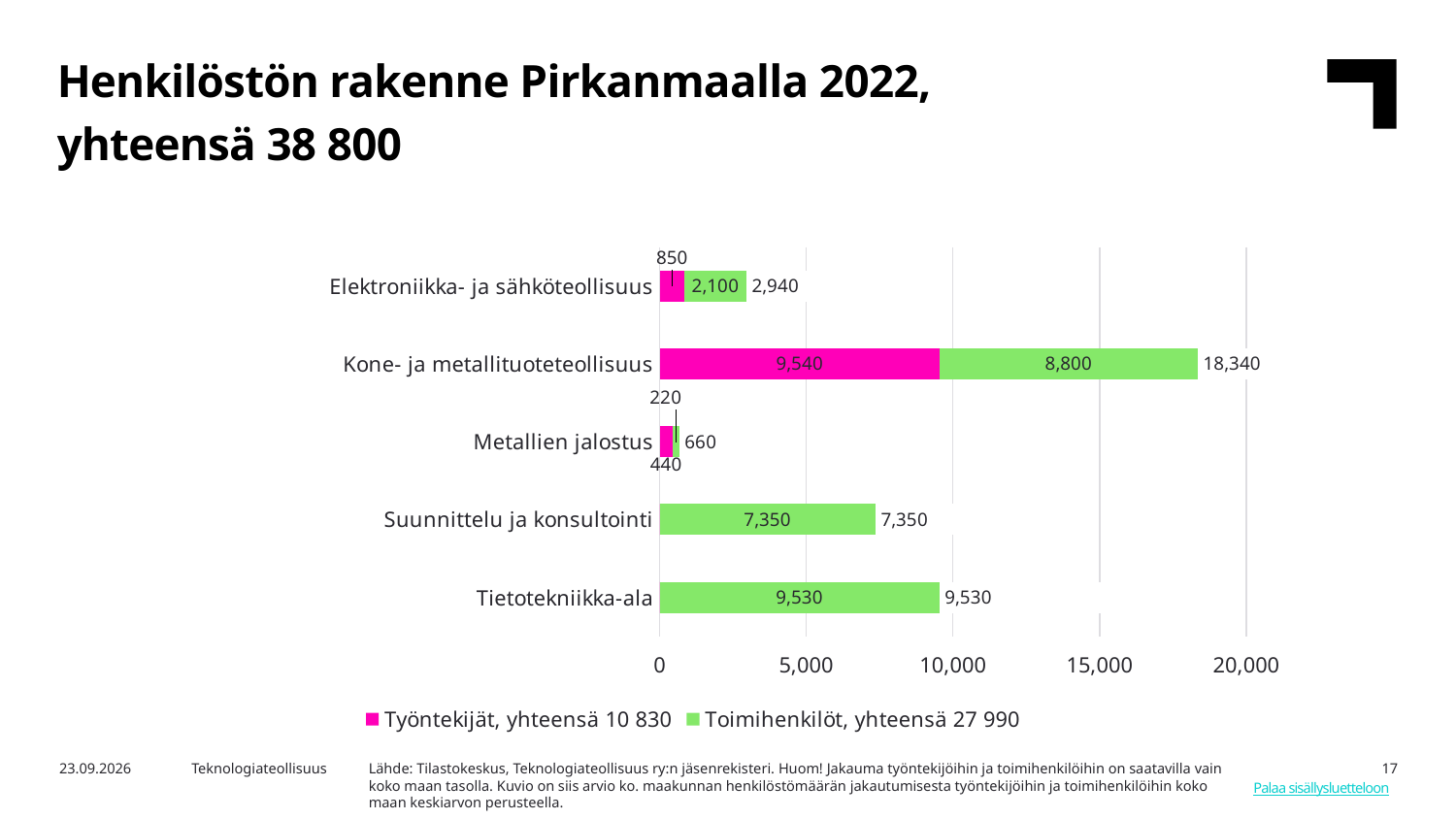
What is the difference between the Työntekijät and Toimihenkilöt values for Kone- ja metallituoteteollisuus? 740 What type of chart is shown on the slide? Stacked bar chart What is the total for Metallien jalostus? 660 Which is larger, the total for Tietotekniikka-ala or the total for Suunnittelu ja konsultointi? Tietotekniikka-ala According to the legend, what is the overall total for Toimihenkilöt? 27 990 How many series does the legend list? 2 What is the Toimihenkilöt value for Elektroniikka- ja sähköteollisuus? 2,100 Which category has the lowest total? Metallien jalostus What is the Työntekijät value for Kone- ja metallituoteteollisuus? 9,540 Which category has the highest total? Kone- ja metallituoteteollisuus What is the total for Kone- ja metallituoteteollisuus? 18,340 How many categories (industries) are shown on the chart? 5